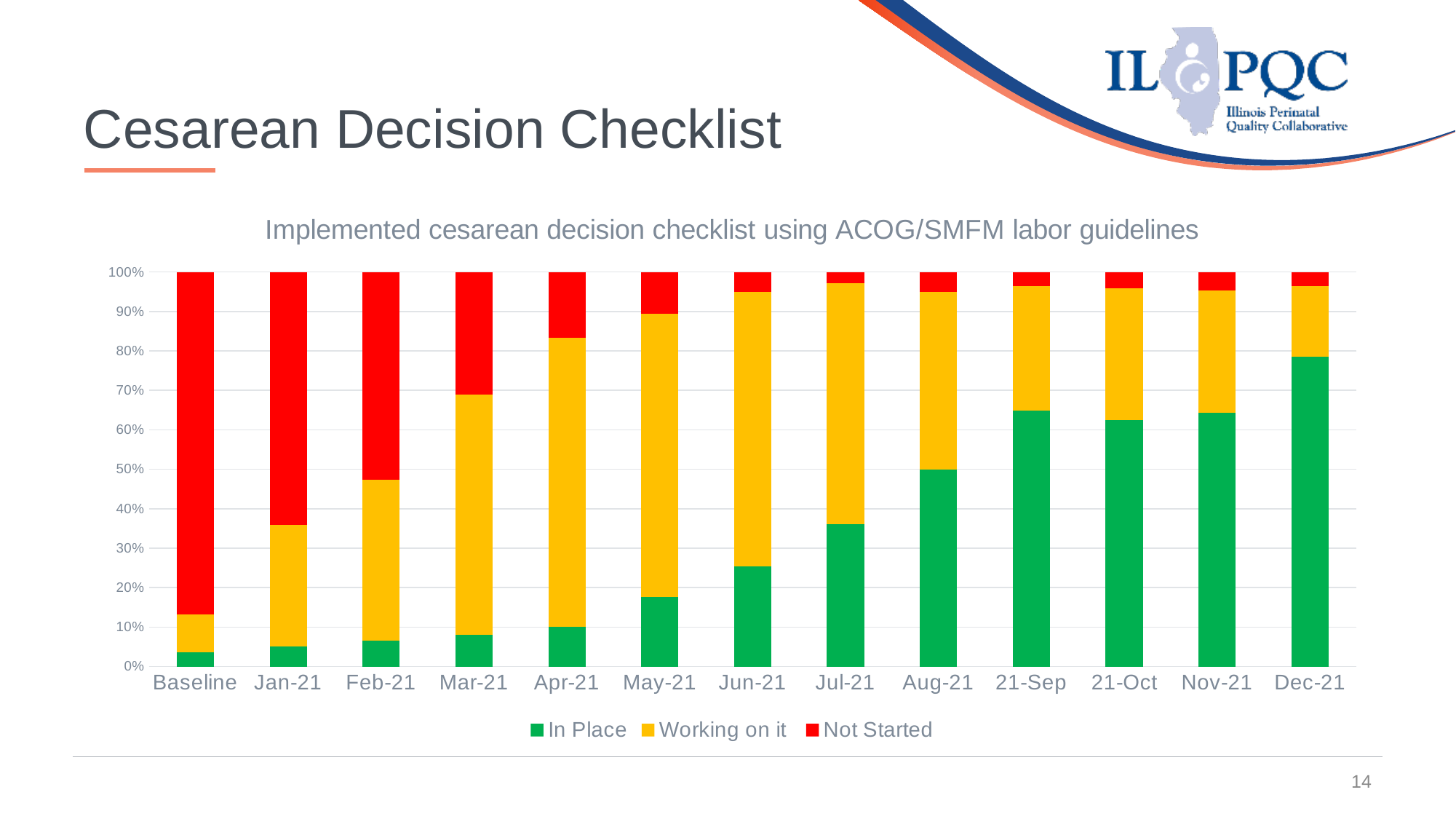
Is the 'In Place' value for 21-Sep greater or less than 60%? greater In which category is the 'Not Started' share the highest? Baseline Is the 'In Place' value for Dec-21 greater or less than 70%? greater In which category is the 'In Place' share the highest? Dec-21 How many series does the legend list? 3 Which colour represents the 'Not Started' series? Red How many categories are shown along the x axis? 13 What kind of chart is shown on the slide? Stacked bar chart What is the title of the chart? Implemented cesarean decision checklist using ACOG/SMFM labor guidelines Is the 'Not Started' value for Baseline greater or less than 80%? greater Does the 'In Place' share rise or fall from Baseline to Dec-21? Rise